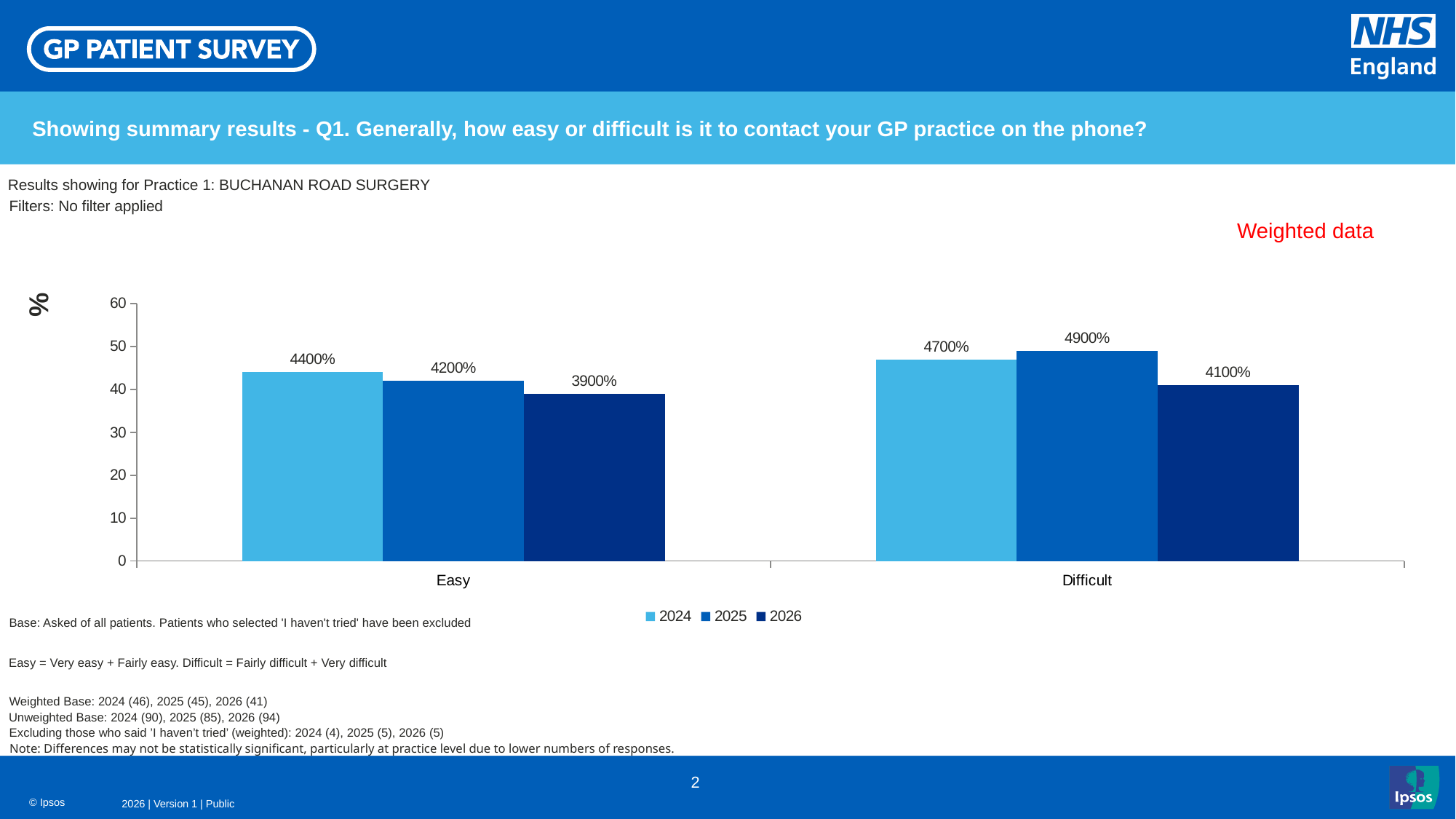
How many categories are shown on the x axis? 2 Which year has the highest value in the Difficult category? 2025 What is the value shown for 2024 in the Easy category? 4400% What is the difference between the 2024 and 2026 values in the Easy category? 500% What kind of chart is shown on the slide? bar chart What is the value shown for 2025 in the Easy category? 4200% Do the values for the Easy category rise or fall from 2024 to 2026? fall Is the 2025 value for Difficult greater or less than 40? greater How many series does the legend list? 3 Which is larger: the 2024 value for Easy or the 2024 value for Difficult? Difficult Which year has the lowest value in the Easy category? 2026 What is the value shown for 2026 in the Difficult category? 4100%